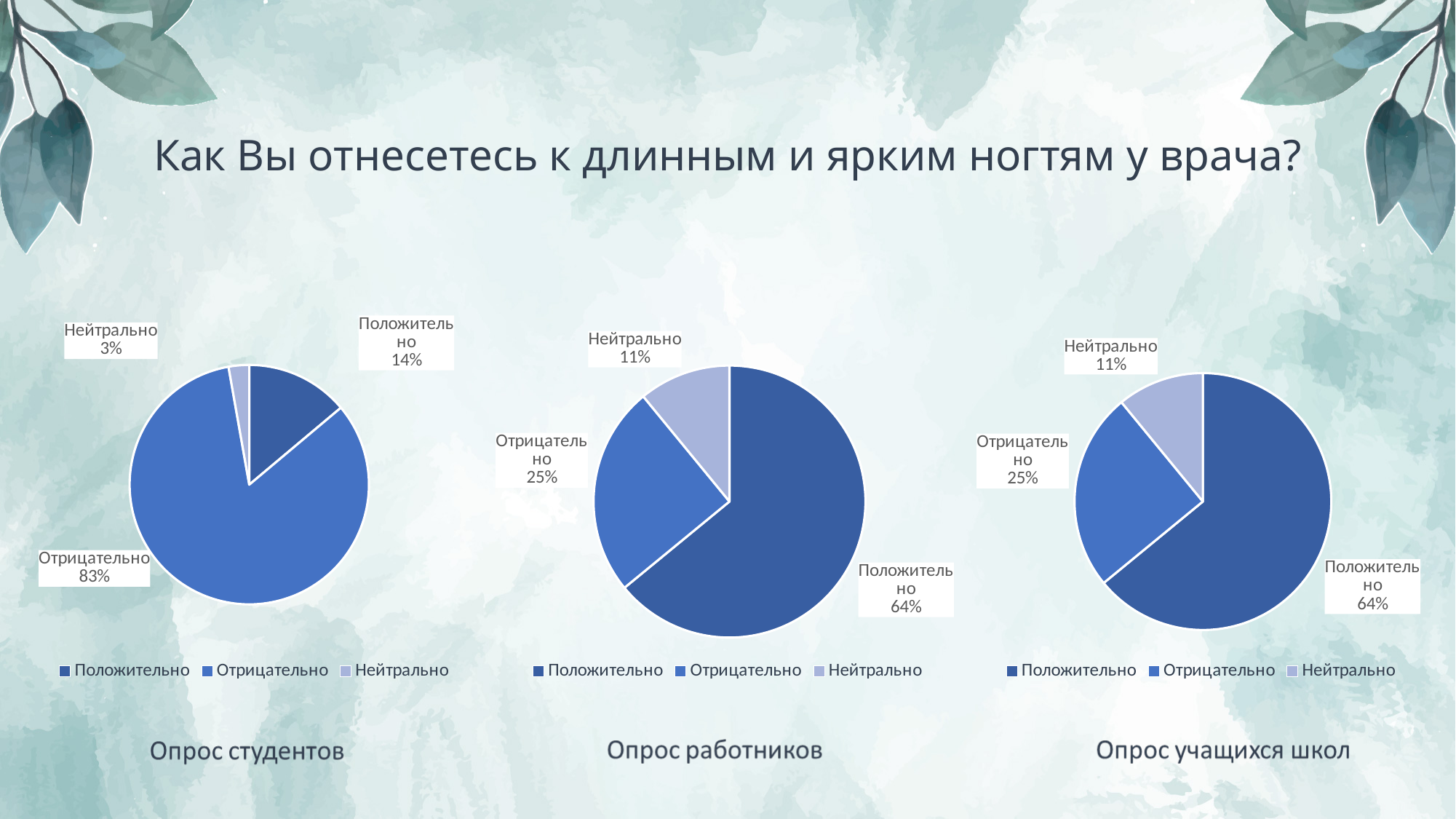
How many entries does the legend of the "Опрос студентов" chart list? 3 In the "Опрос работников" chart, what share of respondents answered "Положительно"? 64% In the "Опрос студентов" chart, what share of respondents answered "Нейтрально"? 3% In the "Опрос студентов" chart, what share of respondents answered "Отрицательно"? 83% In the "Опрос учащихся школ" chart, which answer has the largest slice? Положительно In the "Опрос работников" chart, which answer has the smallest slice? Нейтрально What type of chart is used for "Опрос работников"? Pie chart In the "Опрос студентов" chart, which answer has the largest slice? Отрицательно How many slices does the "Опрос учащихся школ" chart have? 3 In the "Опрос работников" chart, what is the difference between the "Положительно" and "Отрицательно" shares? 39% In the "Опрос учащихся школ" chart, what share of respondents answered "Отрицательно"? 25% In the "Опрос студентов" chart, which is larger: the "Положительно" share or the "Нейтрально" share? Положительно